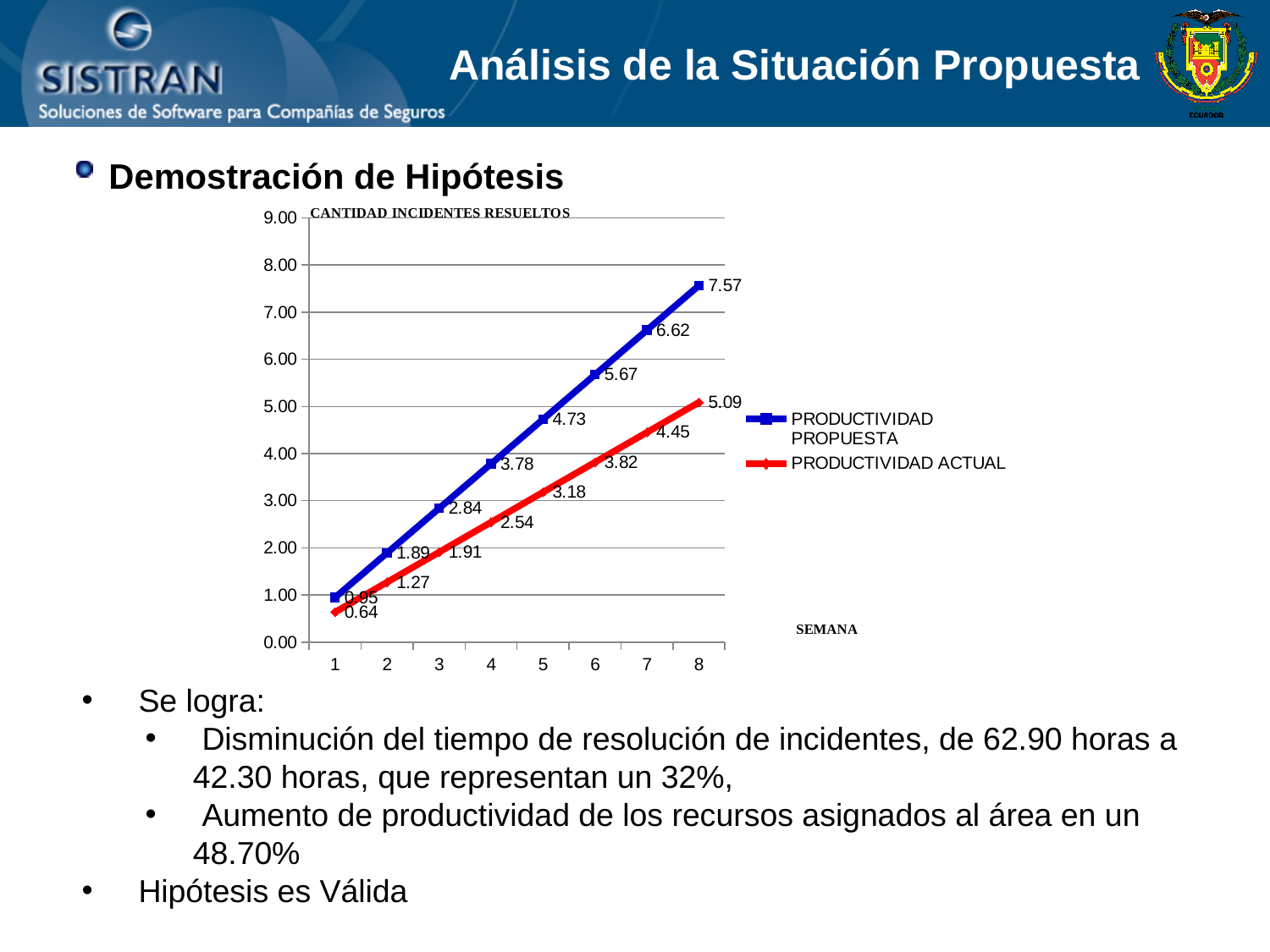
At which week is PRODUCTIVIDAD ACTUAL lowest? 1 What is the value of PRODUCTIVIDAD ACTUAL at week 8? 5.09 What type of chart is shown on the slide? line chart How many series does the legend list? 2 Do the values of PRODUCTIVIDAD ACTUAL rise or fall from week 1 to week 8? rise What is the value of PRODUCTIVIDAD PROPUESTA at week 5? 4.73 What is the value of PRODUCTIVIDAD ACTUAL at week 1? 0.64 What is the difference between PRODUCTIVIDAD PROPUESTA and PRODUCTIVIDAD ACTUAL at week 8? 2.48 How many weeks are plotted on the x axis? 8 At which week does PRODUCTIVIDAD PROPUESTA reach its highest value? 8 Which series has the larger value at week 6, PRODUCTIVIDAD PROPUESTA or PRODUCTIVIDAD ACTUAL? PRODUCTIVIDAD PROPUESTA What is the value of PRODUCTIVIDAD PROPUESTA at week 8? 7.57